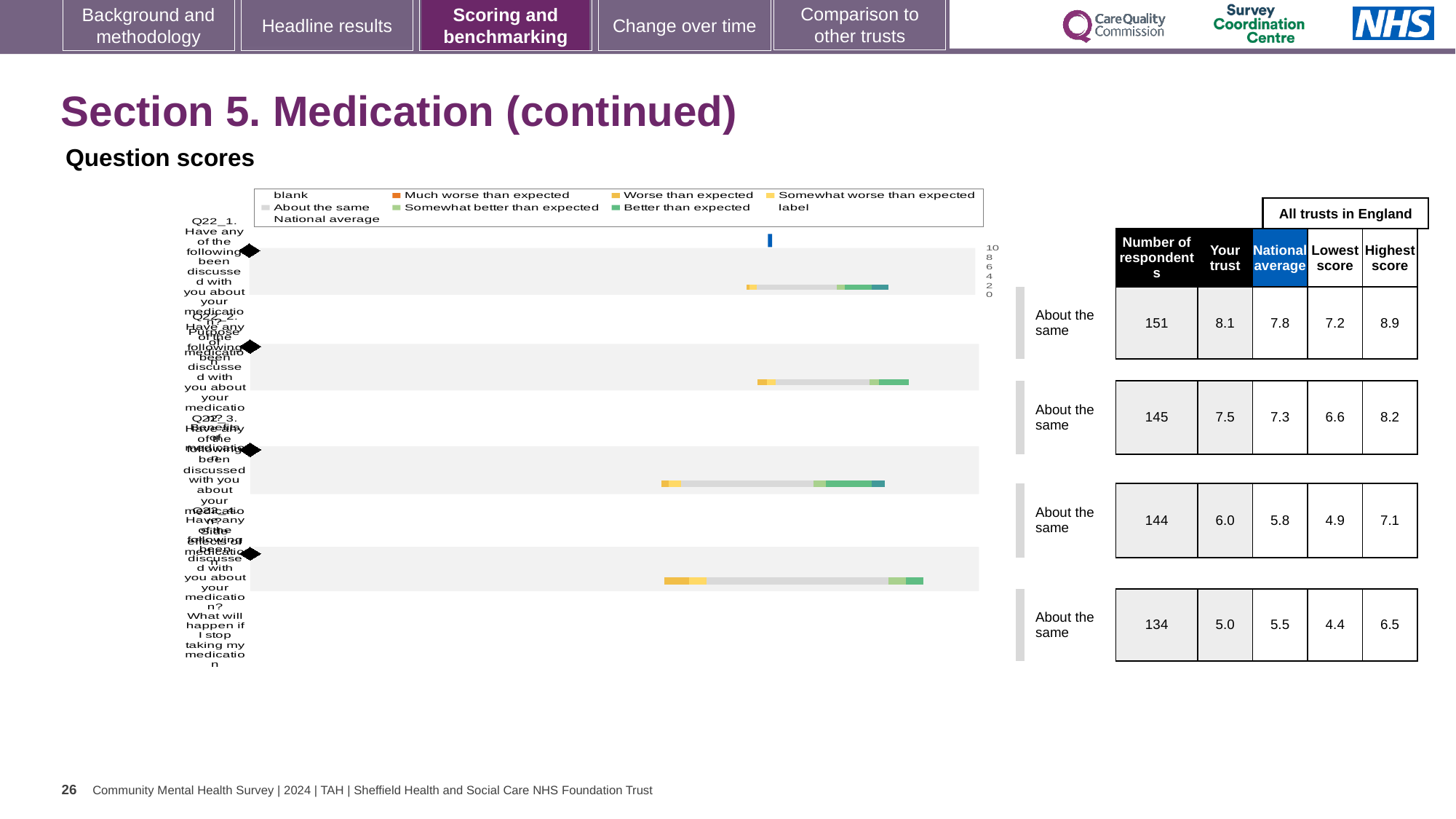
What benchmark category label is shown beside each of the four rows? About the same What kind of chart is shown on the slide? bar chart Which row has the lowest number of respondents? Q22_4 (134) What is the highest score across all trusts in England for the second row (Q22_2)? 8.2 For the last row (Q22_4), which is larger: the 'Your trust' score or the national average? National average (5.5) Which row has the highest 'Your trust' score? Q22_1 (8.1) In the table next to the chart, what is the number of respondents for the first row (Q22_1)? 151 What is the 'Your trust' score for the last row (Q22_4, 'What will happen if I stop taking my medication')? 5.0 What is the difference between the 'Your trust' score and the national average for the first row (Q22_1)? 0.3 What colour does the legend use for 'Much worse than expected'? Orange How many question rows (Q22_1 to Q22_4) are plotted in the chart? 4 What is the lowest score across all trusts in England for the third row (Q22_3)? 4.9